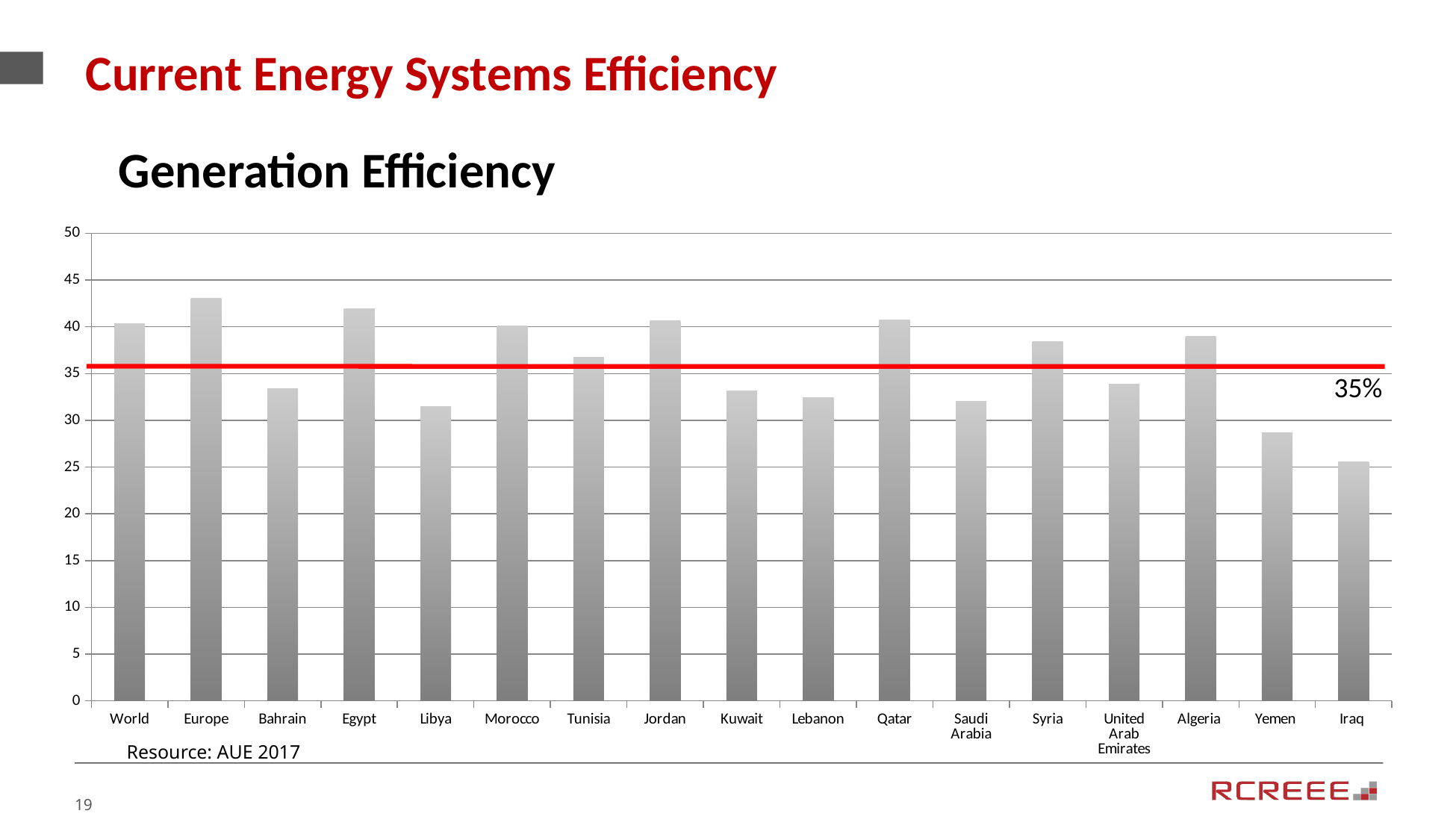
Which category has the highest generation efficiency? Europe Is the value for Libya greater or less than 35? less Which has a higher generation efficiency, Europe or Iraq? Europe Which has a higher generation efficiency, Saudi Arabia or Qatar? Qatar What source is cited below the chart? AUE 2017 What kind of chart is shown on the slide? bar chart Is the value for Egypt greater or less than 40? greater How many countries or regions are shown on the x axis of the Generation Efficiency chart? 17 Is the value for Iraq greater or less than 30? less What percentage is labelled next to the red horizontal line on the chart? 35% Which category has the lowest generation efficiency? Iraq